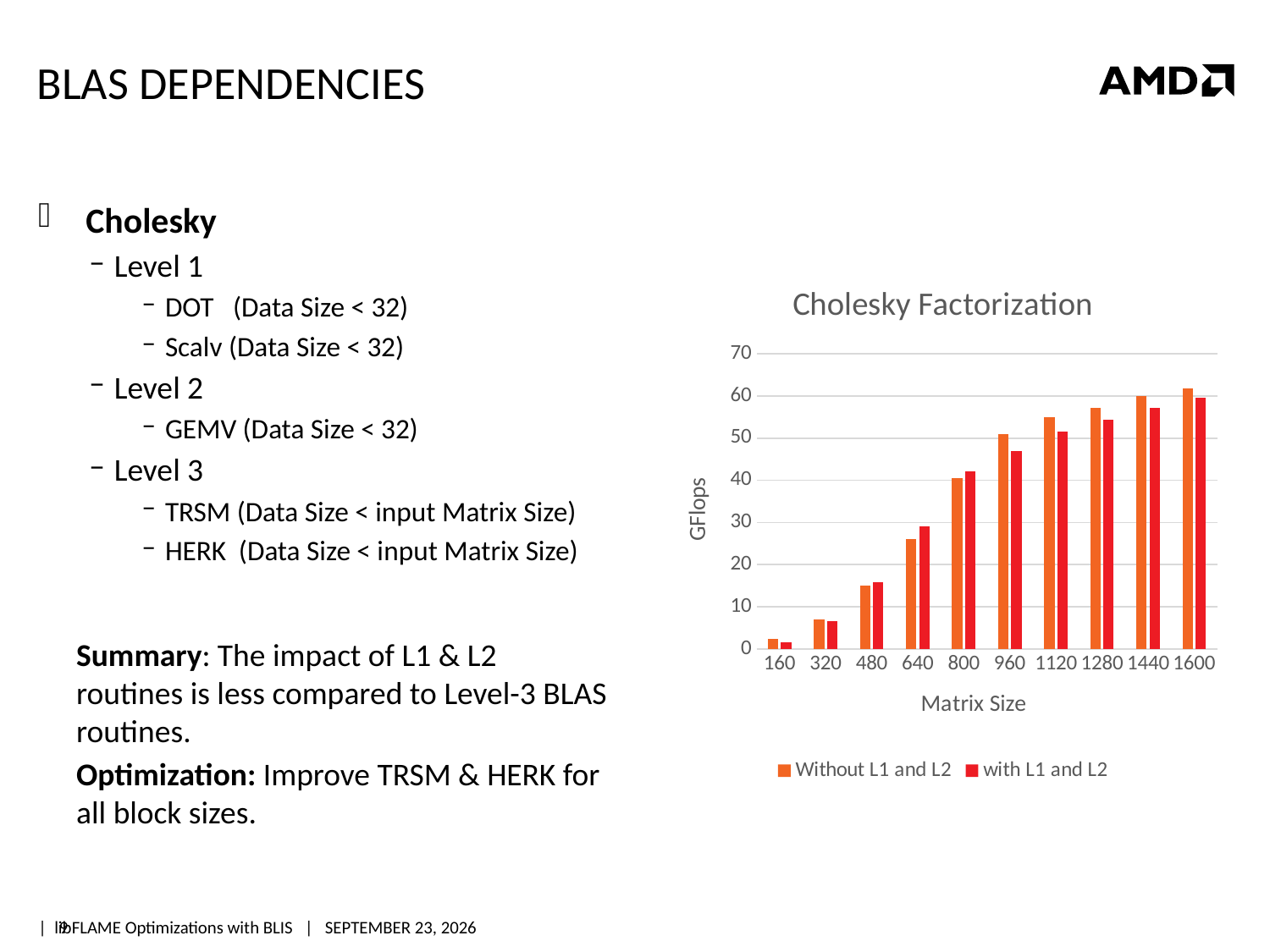
In the Cholesky Factorization chart, is the 'Without L1 and L2' value at matrix size 800 greater or less than 30? greater In the Cholesky Factorization chart, which series has the larger value at matrix size 960? Without L1 and L2 In the Cholesky Factorization chart, at which matrix size is the 'with L1 and L2' value lowest? 160 In the Cholesky Factorization chart, do the GFlops values rise or fall as matrix size increases? rise What kind of chart is the Cholesky Factorization chart? bar chart What is the y-axis label of the Cholesky Factorization chart? GFlops In the Cholesky Factorization chart, at which matrix size is the 'Without L1 and L2' value highest? 1600 In the Cholesky Factorization chart, is the 'Without L1 and L2' value at matrix size 320 greater or less than 10? less How many matrix sizes are plotted on the x axis of the Cholesky Factorization chart? 10 In the Cholesky Factorization chart, which series has the larger value at matrix size 640? with L1 and L2 In the Cholesky Factorization chart, is the 'with L1 and L2' value at matrix size 640 greater or less than 20? greater How many series does the legend of the Cholesky Factorization chart list? 2